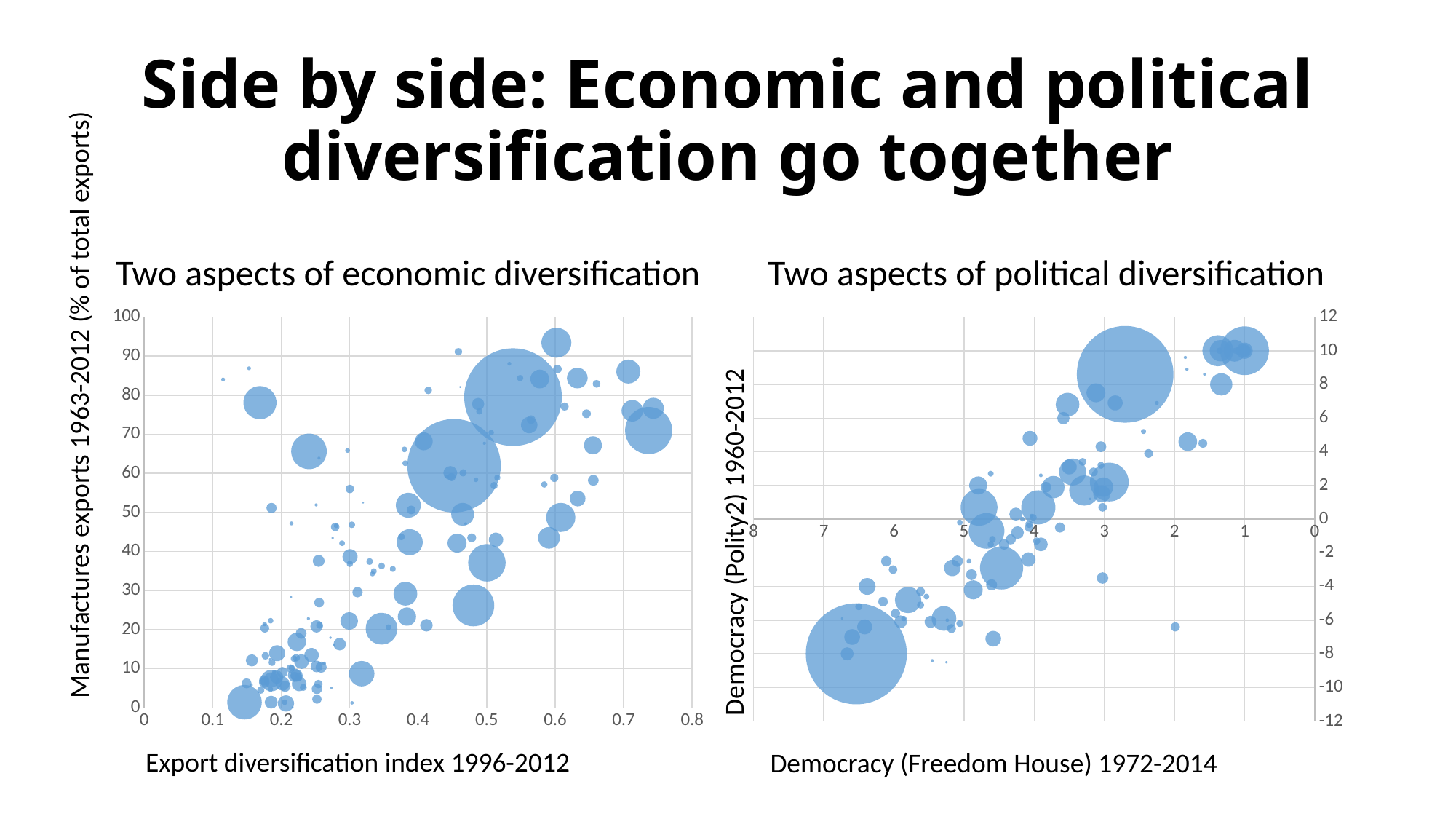
What kind of chart is the left chart titled 'Two aspects of economic diversification'? Bubble chart What kind of chart is the right chart titled 'Two aspects of political diversification'? Bubble chart In the right chart 'Two aspects of political diversification', do the Polity2 values generally rise or fall moving from left to right along the x axis? Rise What is the x-axis label of the left chart 'Two aspects of economic diversification'? Export diversification index 1996-2012 What is the y-axis label of the right chart 'Two aspects of political diversification'? Democracy (Polity2) 1960-2012 In the left chart 'Two aspects of economic diversification', do the plotted values generally rise or fall as the export diversification index increases along the x axis? Rise